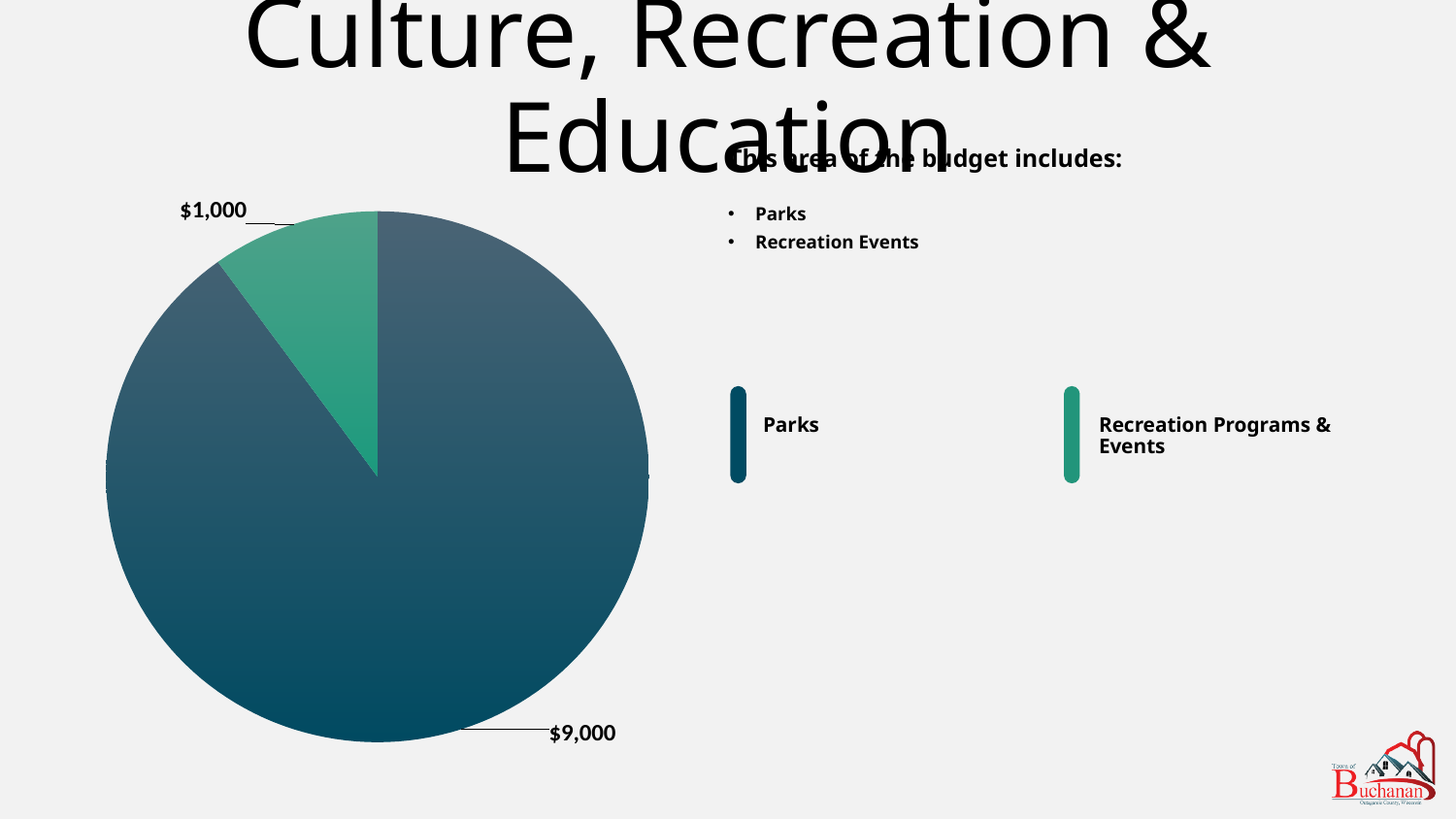
What is the total of all slices in the pie chart? $10,000 How many entries does the legend list? 2 Which legend entry is shown in the lighter green colour? Recreation Programs & Events What is the value for Recreation Programs & Events in the pie chart? $1,000 Which category has the smallest slice of the pie chart? Recreation Programs & Events What kind of chart is shown on the slide? pie chart What is the difference between the Parks value and the Recreation Programs & Events value? $8,000 Which category has the largest slice of the pie chart? Parks How many slices does the pie chart have? 2 Which is larger, the value for Parks or the value for Recreation Programs & Events? Parks What is the value for Parks in the pie chart? $9,000 What share of the pie does the Parks slice represent? 90%